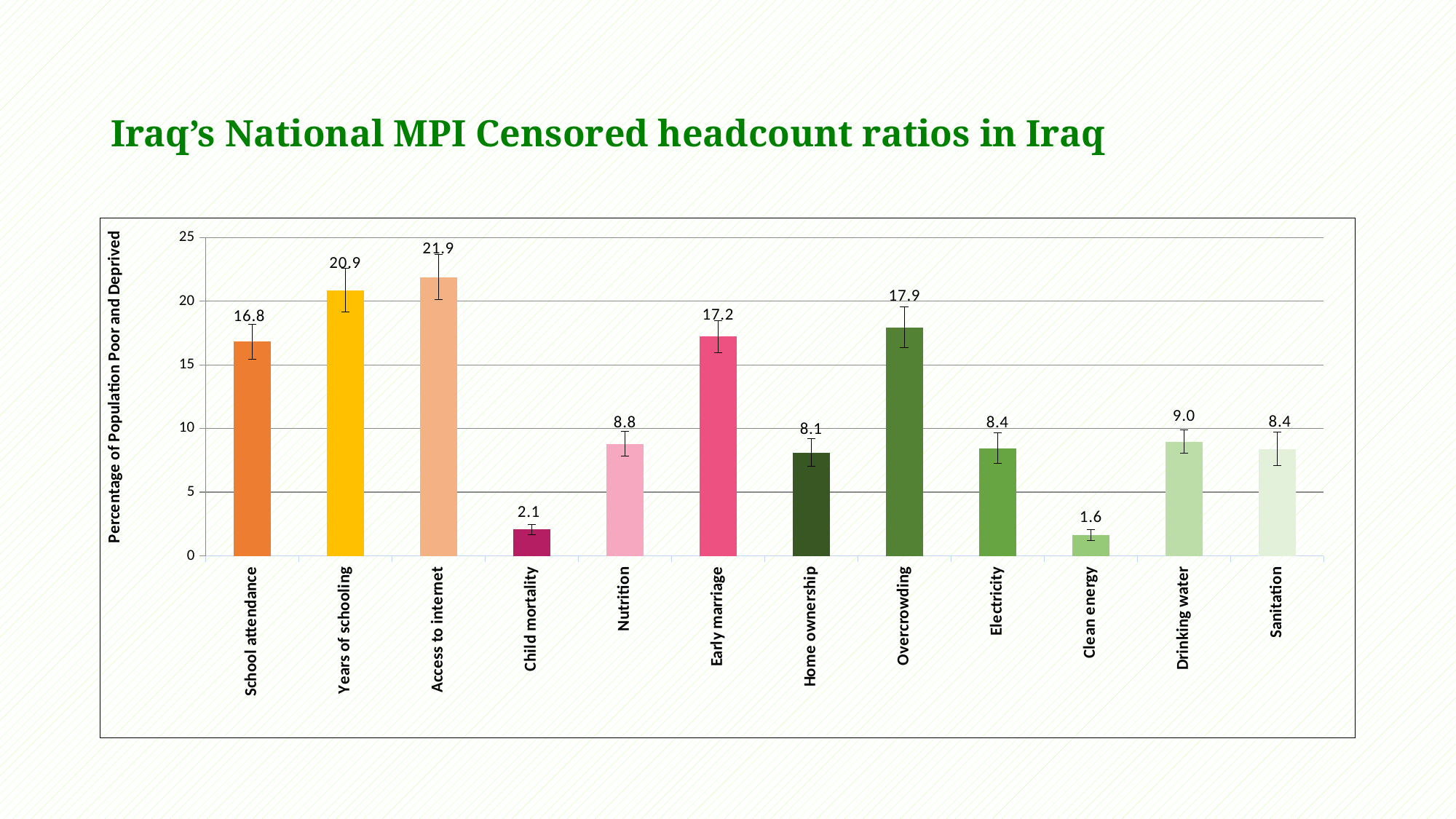
What is the difference between the values for Years of schooling and School attendance? 4.1 What is the value for Overcrowding? 17.9 Which category has the lowest value? Clean energy What kind of chart is shown on the slide? bar chart Which is larger, the value for Early marriage or the value for Overcrowding? Overcrowding What is the label of the vertical axis? Percentage of Population Poor and Deprived What is the value for Access to internet? 21.9 Is the value for Drinking water greater or less than 10? less How many categories are shown on the x axis? 12 What is the title of the slide? Iraq's National MPI Censored headcount ratios in Iraq What is the value for Child mortality? 2.1 Which category has the highest value? Access to internet